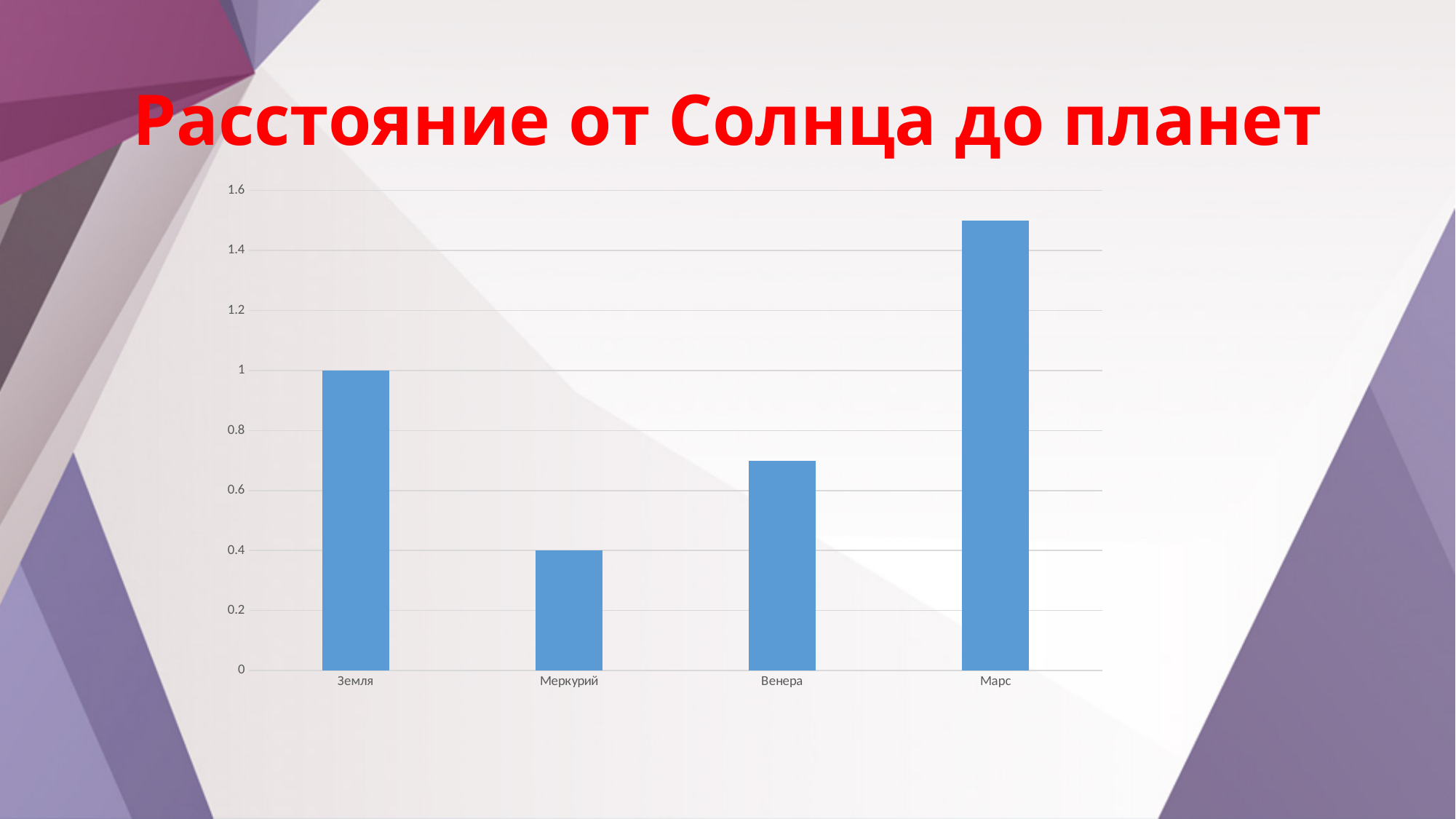
Which planet has the highest value in the chart? Марс Is the value for Марс greater or less than 1.4? greater What is the value for Меркурий in the chart? 0.4 What type of chart is shown on the slide? bar chart Which has a larger value, Венера or Земля? Земля What is the title shown above the chart on the slide? Расстояние от Солнца до планет What is the value for Земля in the chart? 1 Which planet has the lowest value in the chart? Меркурий What is the difference between the values for Земля and Меркурий? 0.6 Is the value for Венера greater or less than 0.8? less What colour are the bars in the chart? blue How many planets (categories) are shown in the chart? 4